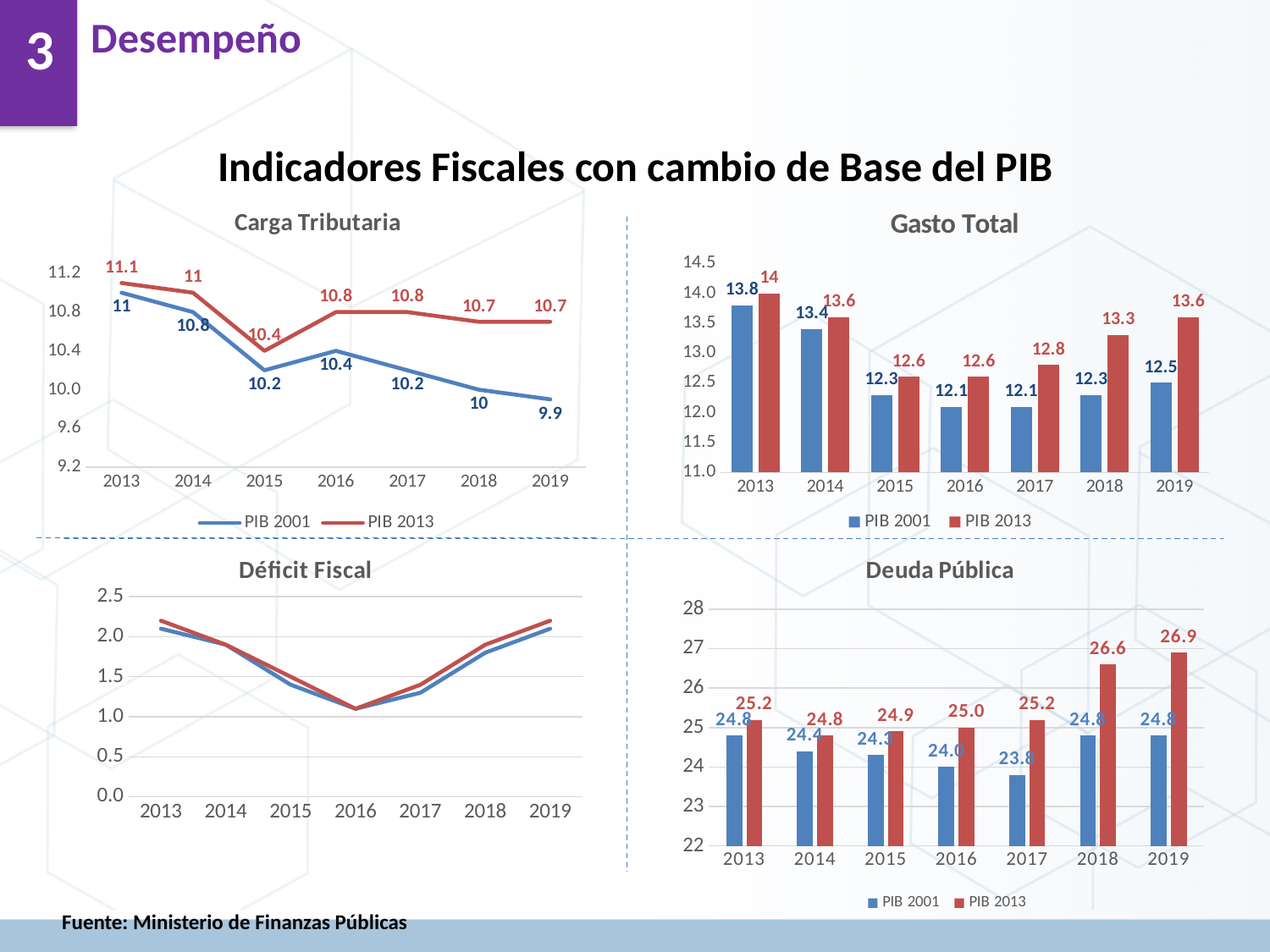
How many series does the legend of the Deuda Pública chart list? 2 In the Carga Tributaria chart, what is the PIB 2001 value for 2019? 9.9 In the Carga Tributaria chart, what is the difference between the PIB 2013 and PIB 2001 values in 2019? 0.8 In the Gasto Total chart, what is the difference between the PIB 2013 and PIB 2001 values in 2019? 1.1 In the Gasto Total chart, what is the PIB 2013 value for 2018? 13.3 What type of chart is the Gasto Total chart? bar chart In the Déficit Fiscal chart, is the value for 2016 greater or less than 1.5? less In the Gasto Total chart, which year has the highest PIB 2001 value? 2013 In the Carga Tributaria chart, what is the PIB 2013 value for 2016? 10.8 In the Deuda Pública chart, which year has the lowest PIB 2001 value? 2017 In the Carga Tributaria chart, does the PIB 2001 series generally rise or fall from 2013 to 2019? fall In the Deuda Pública chart, what is the PIB 2013 value for 2019? 26.9